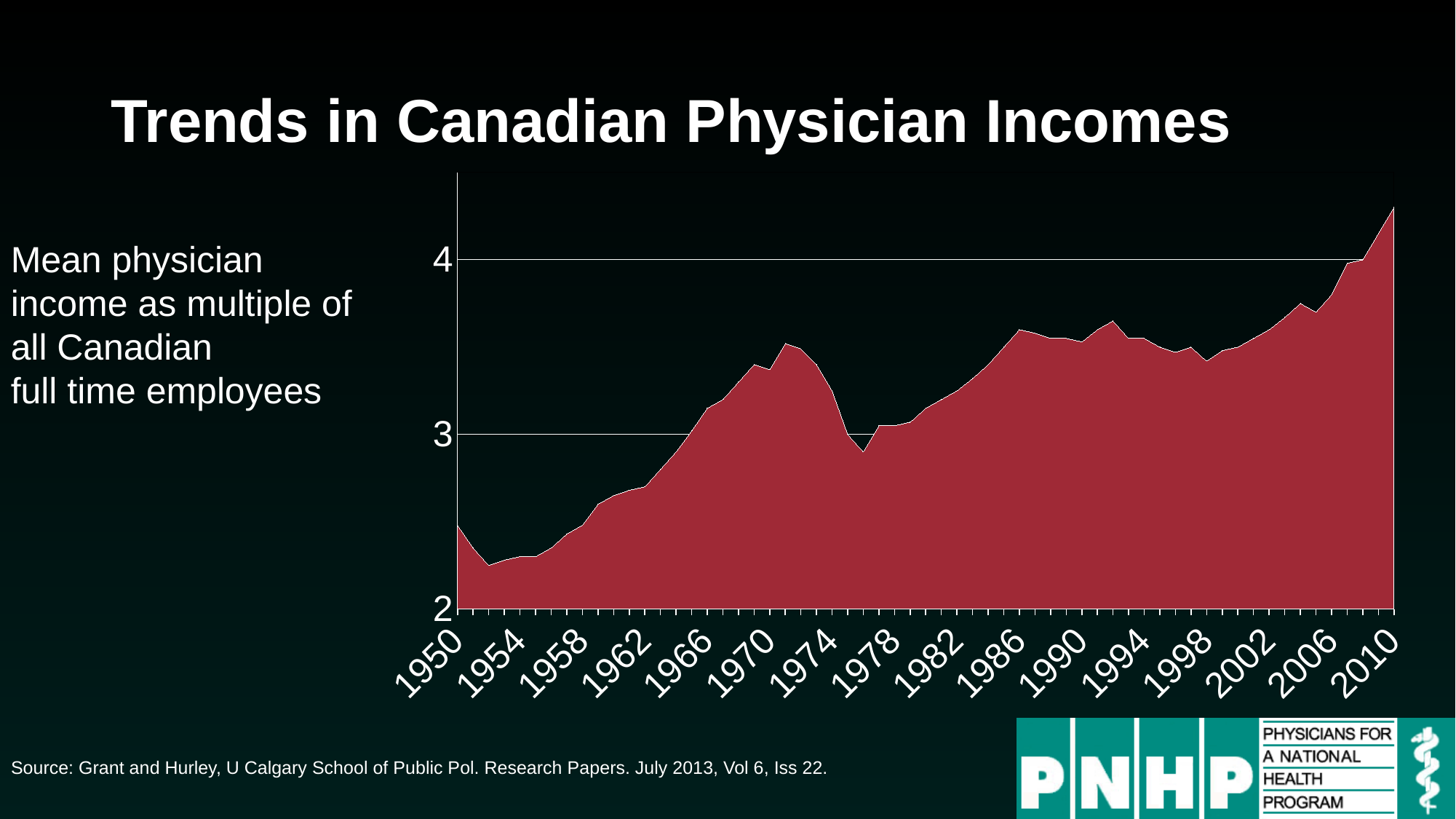
Which labeled year on the x axis has the highest value? 2010 Is the value for 1970 greater or less than 3? greater How many year labels are shown on the x axis? 16 Which is larger, the value for 1970 or the value for 1978? 1970 Is the value for 1998 greater or less than 4? less What kind of chart is shown on the slide? area chart What does the chart's plotted value represent, according to the text on the slide? Mean physician income as multiple of all Canadian full time employees Is the value for 2010 greater or less than 4? greater Which labeled year on the x axis has the lowest value? 1954 What is the title of the slide's chart? Trends in Canadian Physician Incomes Does the value rise or fall between 1970 and 1976? fall